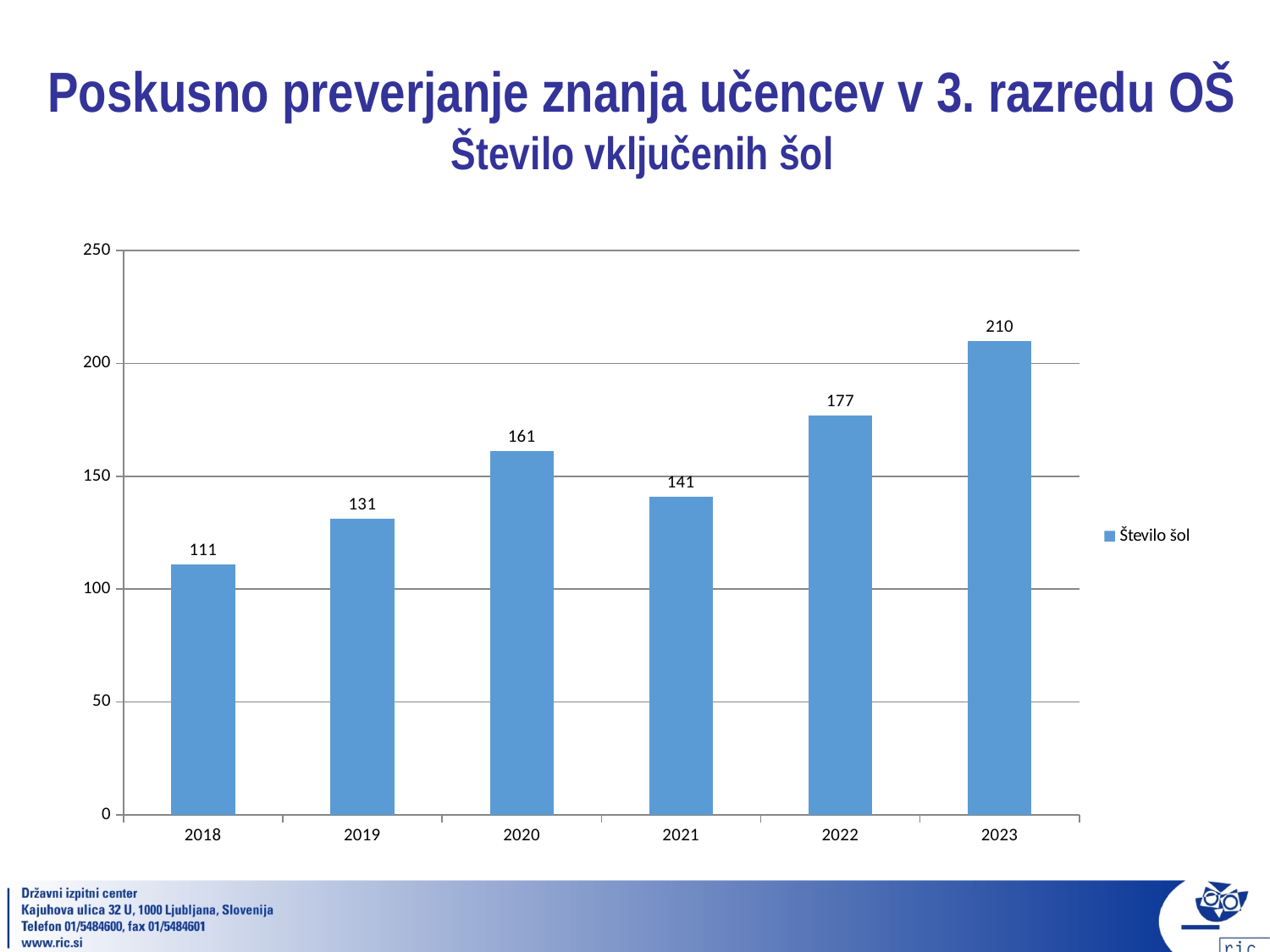
Which year has more schools, 2020 or 2021? 2020 What is the number of schools (Število šol) for 2021? 141 What kind of chart is shown on the slide? Bar chart What is the number of schools (Število šol) for 2023? 210 Is the value for 2022 greater or less than 150? greater How many years are shown on the x axis? 6 How many series does the legend list? 1 Which year has the highest number of schools? 2023 What is the difference in the number of schools between 2023 and 2022? 33 Which year has the lowest number of schools? 2018 What is the difference in the number of schools between 2020 and 2021? 20 What is the number of schools (Število šol) for 2018? 111